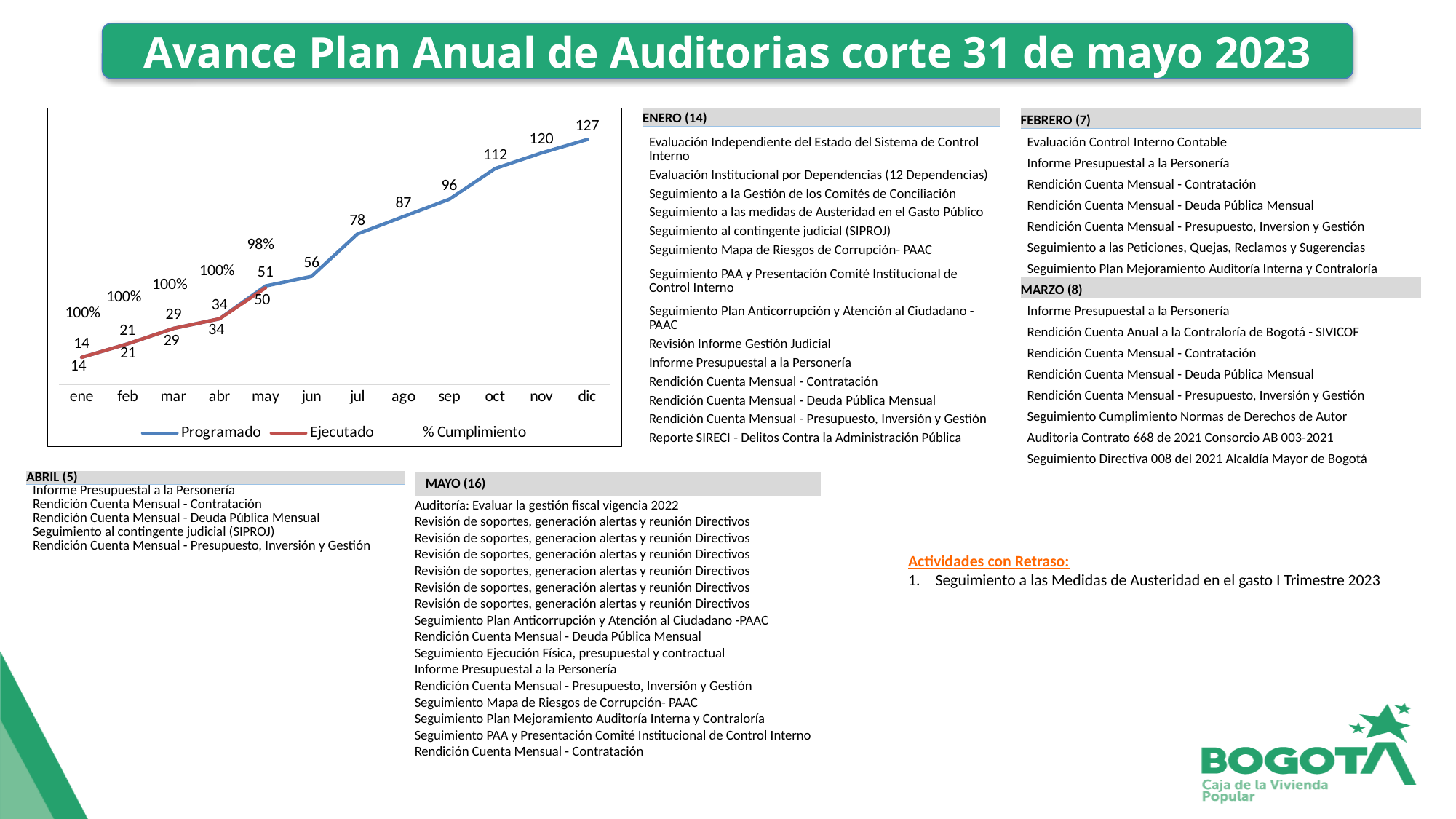
Which is larger, the Programado value for oct or the Programado value for sep? oct What is the Ejecutado value for may? 50 What is the Programado value for dic? 127 What type of chart is shown on the slide? line chart Which month has the highest Programado value? dic What is the Programado value for jul? 78 How many series does the chart legend list? 3 How many months are shown on the x axis of the chart? 12 Which month has the lowest Programado value? ene Does the Programado series rise or fall from ene to dic? rise What is the difference between the Programado and Ejecutado values for may? 1 What is the % Cumplimiento value for may? 98%